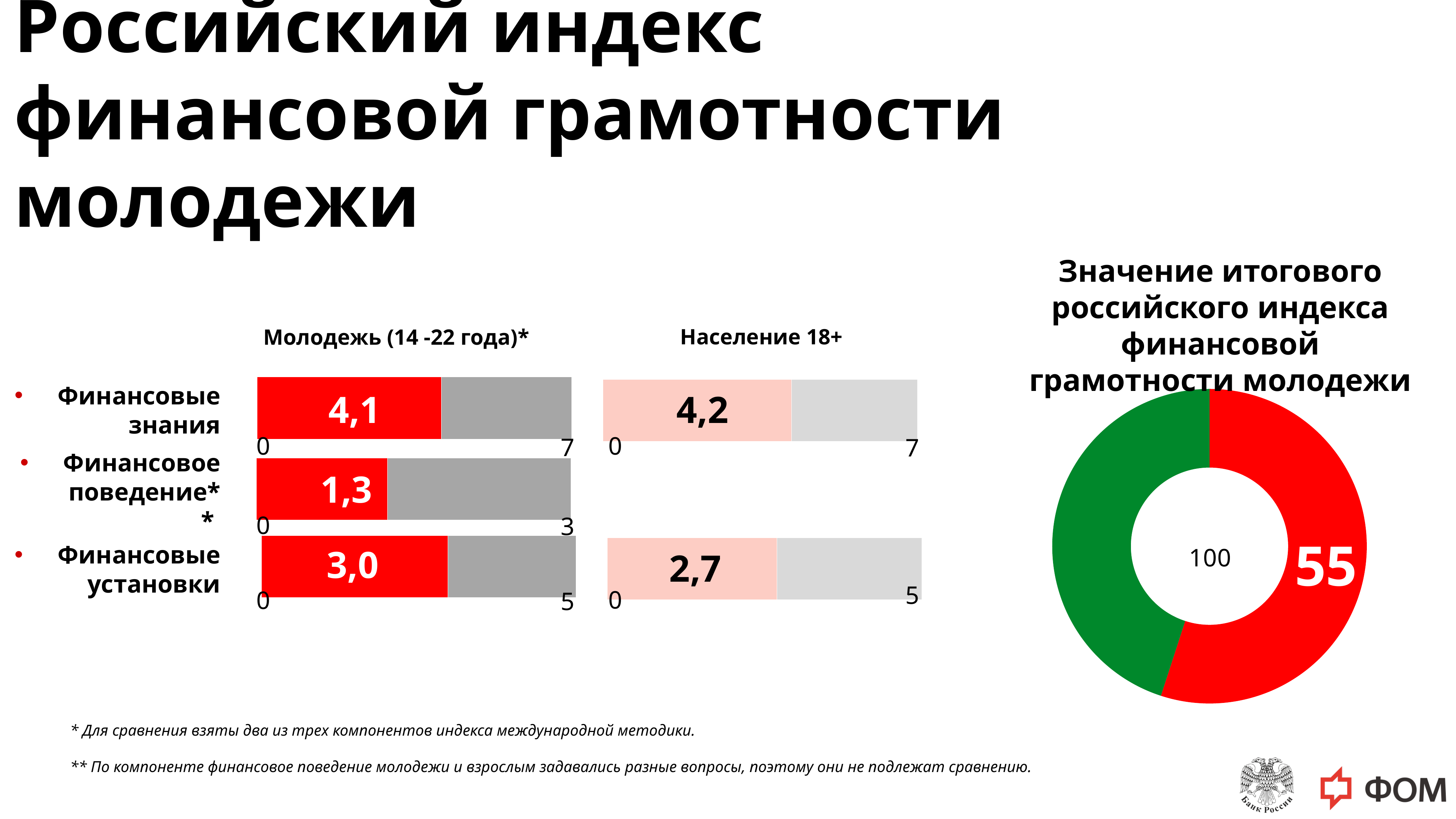
In the bar chart for Население 18+, what is the value for Финансовые установки? 2,7 In the bar chart for Молодежь (14-22 года), what is the value for Финансовые знания? 4,1 For Финансовые установки, which group has the larger value: Молодежь (14-22 года) or Население 18+? Молодежь (14-22 года) For Финансовые знания, which group has the larger value: Молодежь (14-22 года) or Население 18+? Население 18+ How many components are shown in the bar chart for Молодежь (14-22 года)? 3 In the bar chart for Молодежь (14-22 года), which component has the lowest value? Финансовое поведение In the bar chart for Молодежь (14-22 года), what is the value for Финансовое поведение? 1,3 In the bar chart for Население 18+, what is the value for Финансовые знания? 4,2 In the bar chart for Молодежь (14-22 года), what is the value for Финансовые установки? 3,0 What type of chart is used to show the 'Значение итогового российского индекса финансовой грамотности молодежи'? Donut (pie) chart What value is shown in the red segment of the donut chart titled 'Значение итогового российского индекса финансовой грамотности молодежи'? 55 What is the difference between the Финансовые установки values for Молодежь (14-22 года) and Население 18+? 0,3